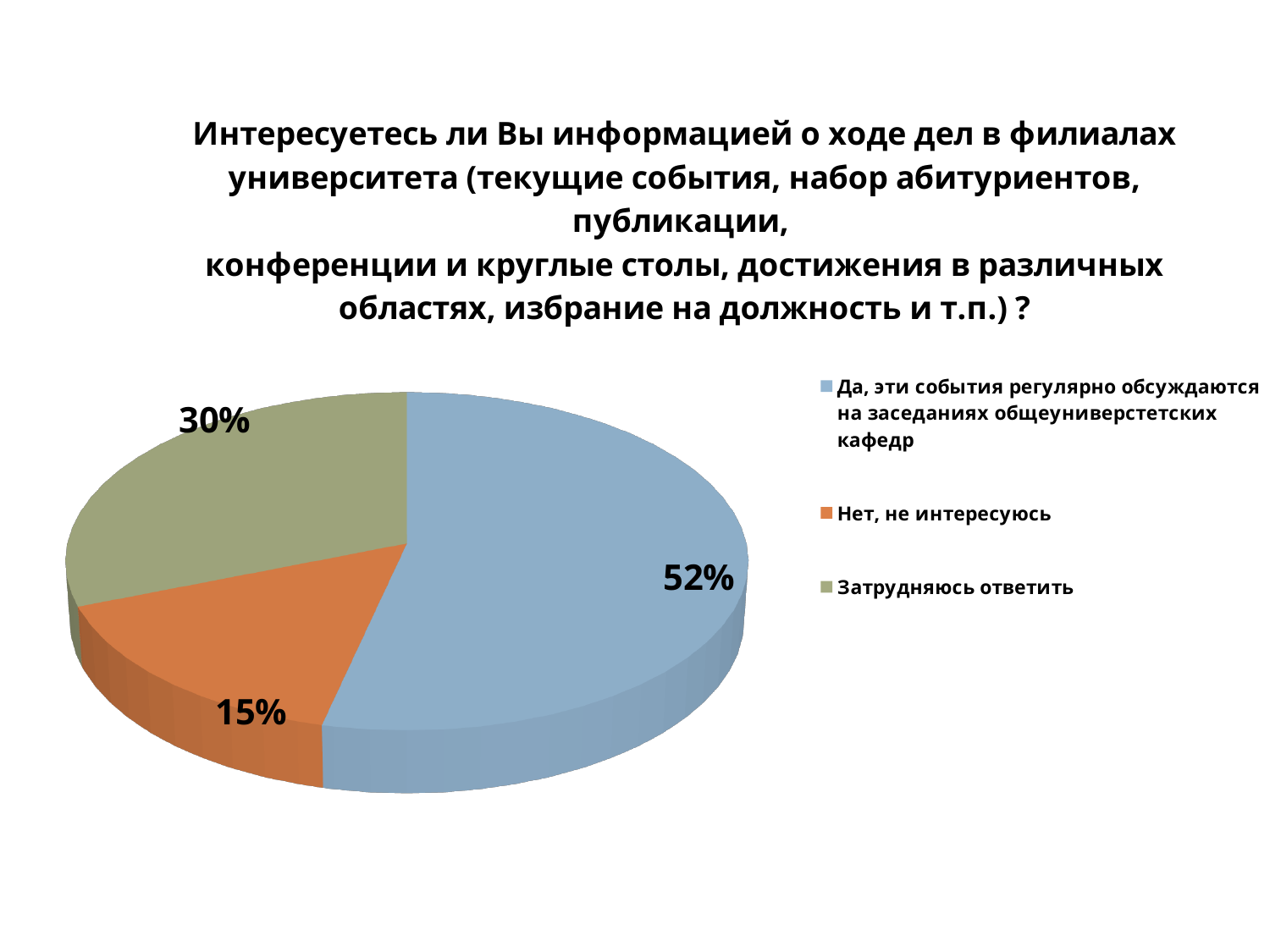
Which answer option has the smallest share of the pie? Нет, не интересуюсь What kind of chart is shown on the slide? Pie chart What percentage of respondents answered "Да, эти события регулярно обсуждаются на заседаниях общеуниверстетских кафедр"? 52% How many entries does the legend list? 3 Which is larger: the share for "Затрудняюсь ответить" or the share for "Нет, не интересуюсь"? Затрудняюсь ответить What colour is the slice for "Нет, не интересуюсь"? Orange What percentage of respondents answered "Затрудняюсь ответить"? 30% How many slices does the pie chart have? 3 What is the difference in percentage points between the "Затрудняюсь ответить" slice and the "Нет, не интересуюсь" slice? 15 What is the difference in percentage points between the largest slice and the "Затрудняюсь ответить" slice? 22 Which answer option has the largest share of the pie? Да, эти события регулярно обсуждаются на заседаниях общеуниверстетских кафедр What percentage of respondents answered "Нет, не интересуюсь"? 15%